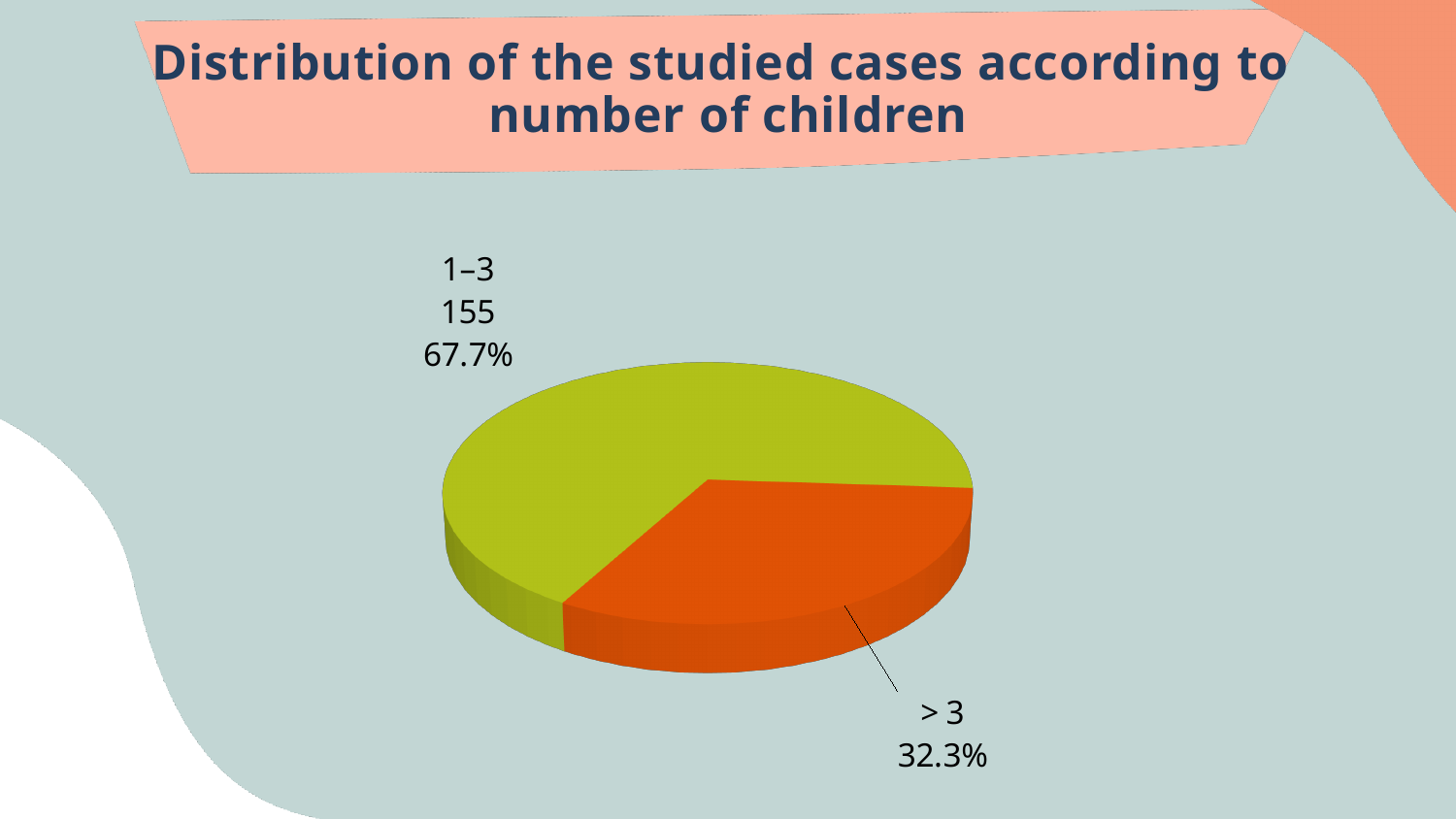
Which category has the smallest share of the pie? > 3 Which share is larger, 1–3 children or > 3 children? 1–3 What percentage of the studied cases had > 3 children? 32.3% What is the difference in percentage points between the 1–3 slice and the > 3 slice? 35.4% How many studied cases had 1–3 children? 155 What kind of chart is shown on the slide? pie chart How many slices does the pie chart have? 2 What percentage of the studied cases had 1–3 children? 67.7% Which category has the largest share of the pie? 1–3 What colour is the slice for > 3 children? orange What is the title of the chart? Distribution of the studied cases according to number of children